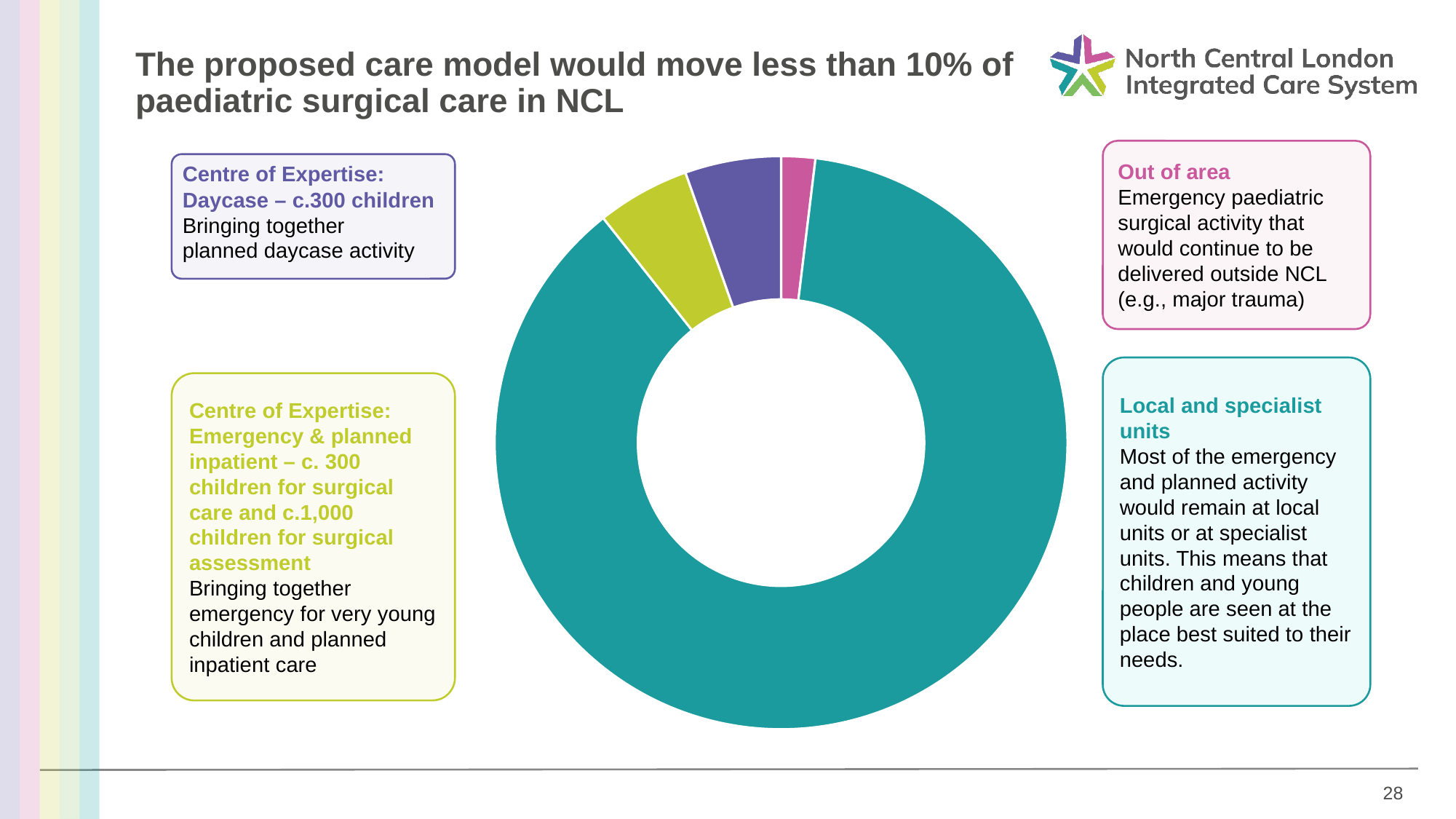
What colour is the slice representing Local and specialist units? Teal Which slice is larger: Local and specialist units or Out of area? Local and specialist units How many slices does the donut chart have? 4 Which category takes up the largest slice of the donut chart? Local and specialist units Which slice is larger: Out of area or Centre of Expertise: Emergency & planned inpatient? Centre of Expertise: Emergency & planned inpatient What kind of chart is shown on the slide? Donut (pie) chart Which category takes up the smallest slice of the donut chart? Out of area What colour is the slice representing Out of area activity? Pink Which slice is larger: Centre of Expertise: Daycase or Local and specialist units? Local and specialist units